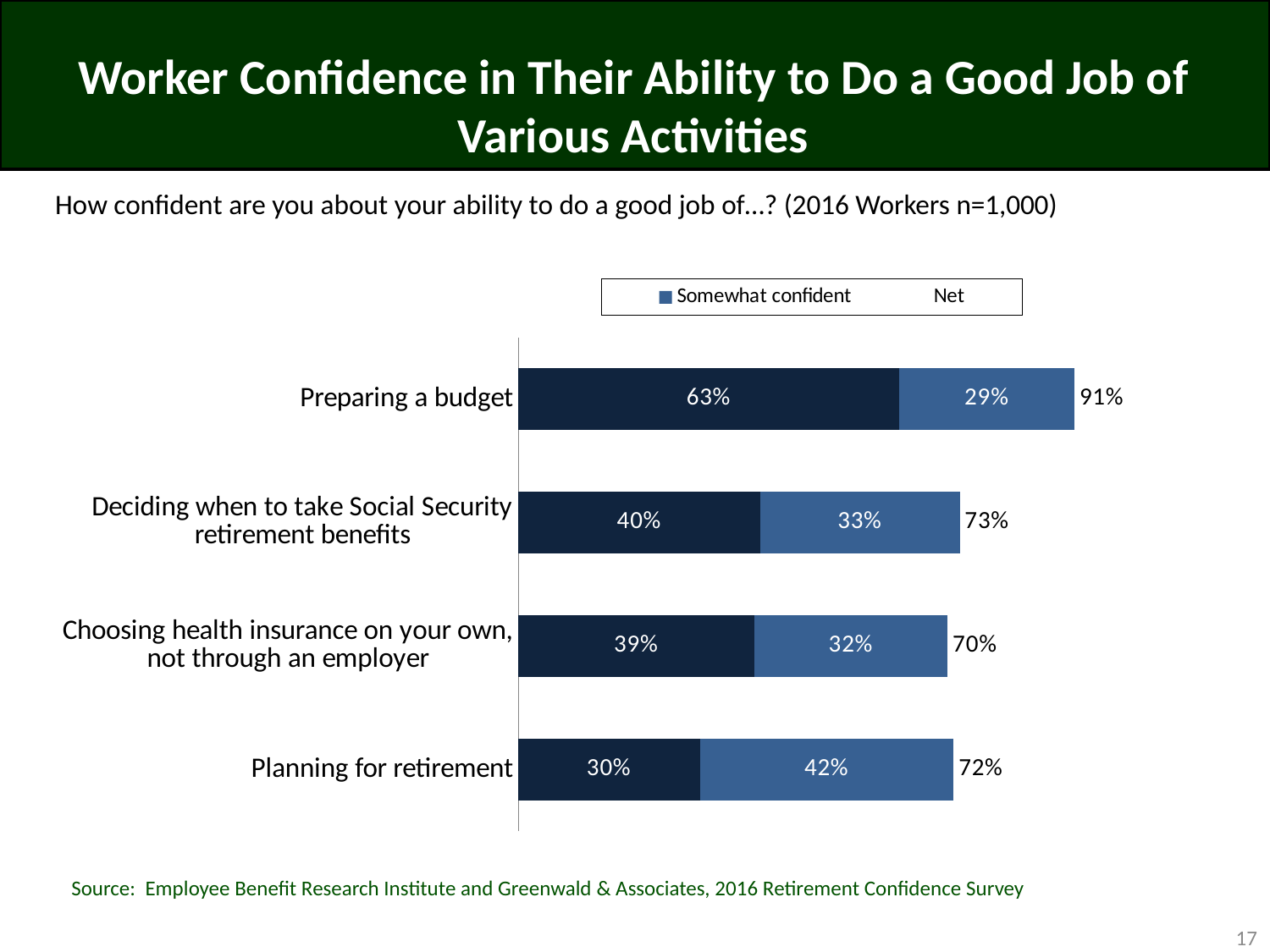
What kind of chart is shown on the slide? Stacked bar chart What is the Net value for Planning for retirement? 72% What is the value of the dark navy segment for Preparing a budget? 63% What is the difference between the Somewhat confident values for Planning for retirement and Preparing a budget? 13 percentage points How many activities are shown in the chart? 4 What is the Somewhat confident value for Deciding when to take Social Security retirement benefits? 33% Which is larger: the Net value for Preparing a budget or the Net value for Choosing health insurance on your own, not through an employer? Preparing a budget Which activity has the highest Somewhat confident value? Planning for retirement What is the Somewhat confident value for Planning for retirement? 42% Which activity has the highest Net value? Preparing a budget What is the Net value for Preparing a budget? 91% Which activity has the lowest Net value? Choosing health insurance on your own, not through an employer